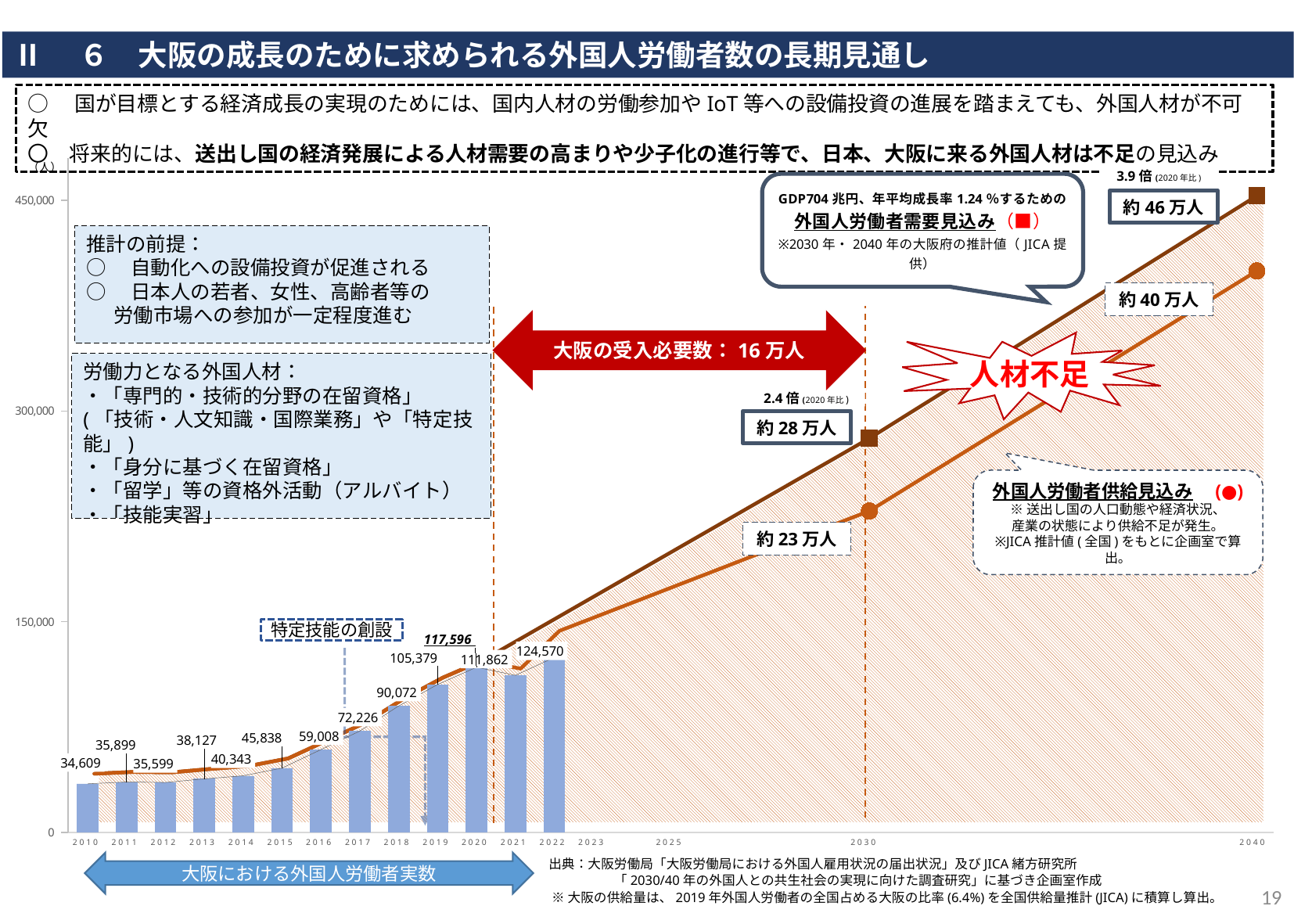
How many years have bars with actual values (2010 to 2022)? 13 Which year among the bars from 2010 to 2022 has the lowest value? 2010 What is the number of foreign workers in Osaka shown for 2022? 124,570 Is the value for 2016 greater or less than 150,000? less Which year among the bars from 2010 to 2022 has the highest value? 2022 What is the value shown for 2010? 34,609 What is the difference between the 2022 value and the 2021 value? 12,708 Do the bar values generally rise or fall from 2010 to 2019? rise Which is larger, the value for 2020 or the value for 2021? 2020 What is the value shown for 2018? 90,072 What is the projected foreign worker demand for Osaka in 2040 (外国人労働者需要見込み)? 約46万人 What is the projected foreign worker supply for Osaka in 2030 (外国人労働者供給見込み)? 約23万人